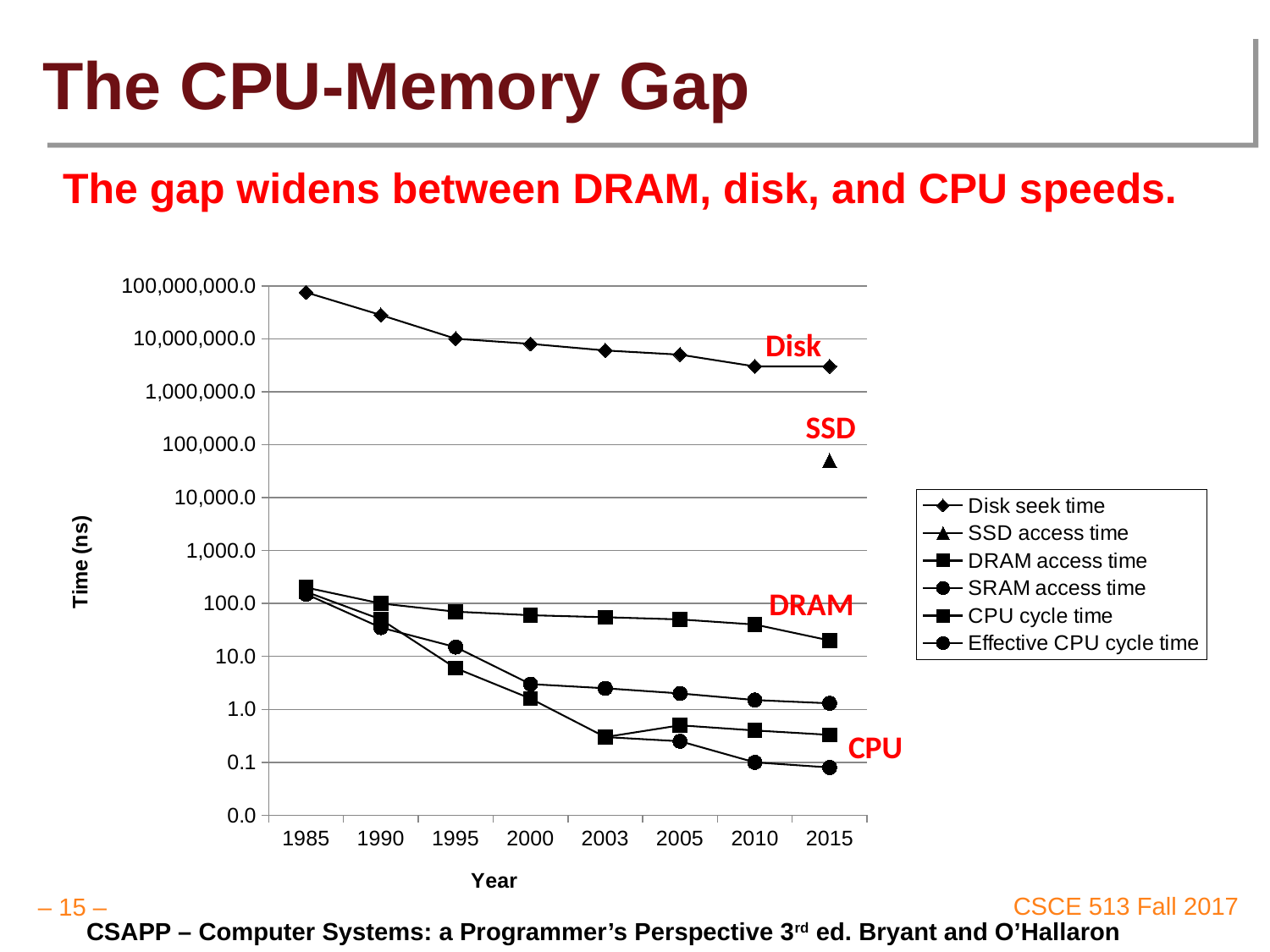
Does the Disk seek time series rise or fall from 1985 to 2015? fall What is the title of the x axis? Year Is the SSD access time value for 2015 greater or less than 100,000.0? less How many years are marked along the x axis? 8 What is the title of the y axis? Time (ns) How many series does the legend list? 6 In 2015, which is larger: Disk seek time or DRAM access time? Disk seek time Which series has the highest value in 2015? Disk seek time Is the DRAM access time value for 2015 greater or less than 100.0? less Is the Disk seek time value for 2015 greater or less than 1,000,000.0? greater What kind of chart is shown on the slide? line chart